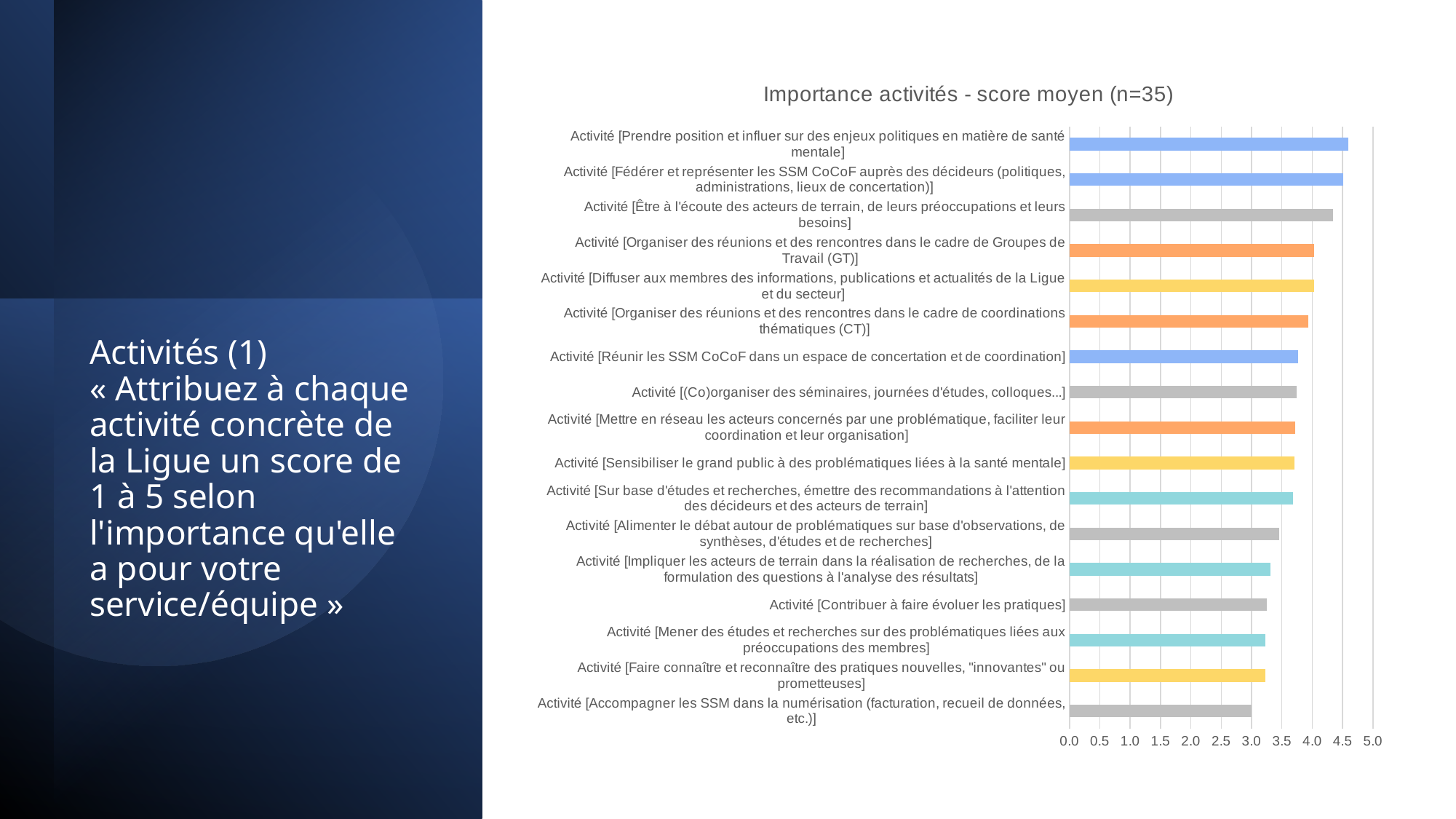
Is the value for 'Activité [Impliquer les acteurs de terrain dans la réalisation de recherches, de la formulation des questions à l'analyse des résultats]' greater or less than 3.5? less Which has a higher score: 'Activité [Prendre position et influer sur des enjeux politiques en matière de santé mentale]' or 'Activité [Contribuer à faire évoluer les pratiques]'? Activité [Prendre position et influer sur des enjeux politiques en matière de santé mentale] Is the value for 'Activité [Réunir les SSM CoCoF dans un espace de concertation et de coordination]' greater or less than 3.5? greater What is the title of the chart? Importance activités - score moyen (n=35) What type of chart is shown on the slide? Bar chart Is the value for 'Activité [Contribuer à faire évoluer les pratiques]' greater or less than 3.0? greater How many activities (categories) are plotted in the chart? 17 What is the maximum value shown on the horizontal axis of the chart? 5.0 Which has a higher score: 'Activité [Accompagner les SSM dans la numérisation (facturation, recueil de données, etc.)]' or 'Activité [Être à l'écoute des acteurs de terrain, de leurs préoccupations et leurs besoins]'? Activité [Être à l'écoute des acteurs de terrain, de leurs préoccupations et leurs besoins] Do the bar values increase or decrease going from the top of the chart to the bottom? Decrease Which activity has the lowest average importance score? Activité [Accompagner les SSM dans la numérisation (facturation, recueil de données, etc.)]